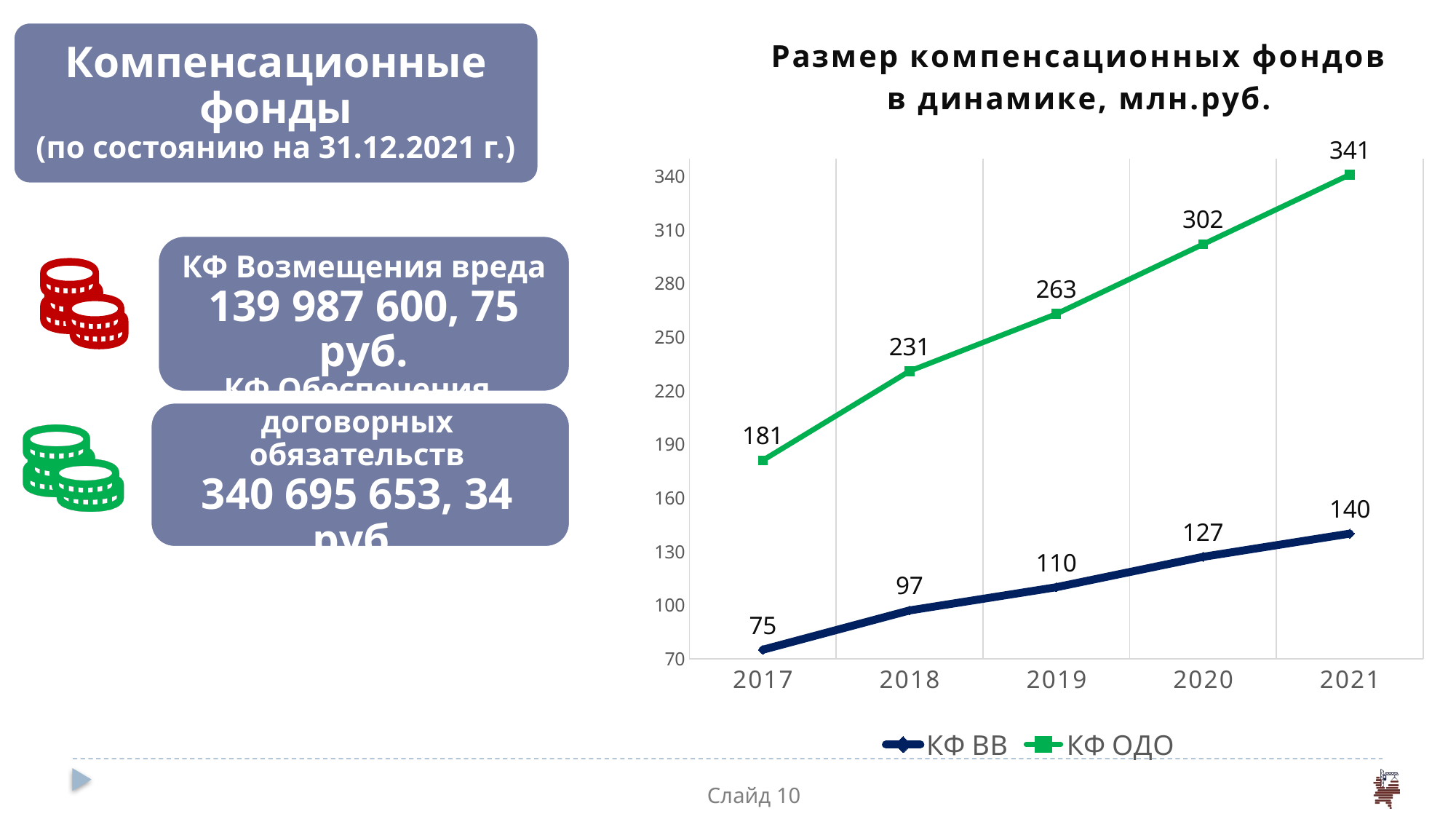
Does КФ ОДО rise or fall from 2017 to 2021? rise What is the value of КФ ВВ in 2018? 97 Which series has the larger value in 2017, КФ ВВ or КФ ОДО? КФ ОДО In which year is КФ ОДО at its highest? 2021 In which year is КФ ВВ at its lowest? 2017 What is the value of КФ ОДО in 2019? 263 How many series does the legend list? 2 What is the difference between КФ ОДО and КФ ВВ in 2020? 175 How many years are shown on the x axis? 5 What kind of chart is shown on the slide? line chart What is the value of КФ ОДО in 2021? 341 By how much did КФ ВВ increase from 2017 to 2021? 65